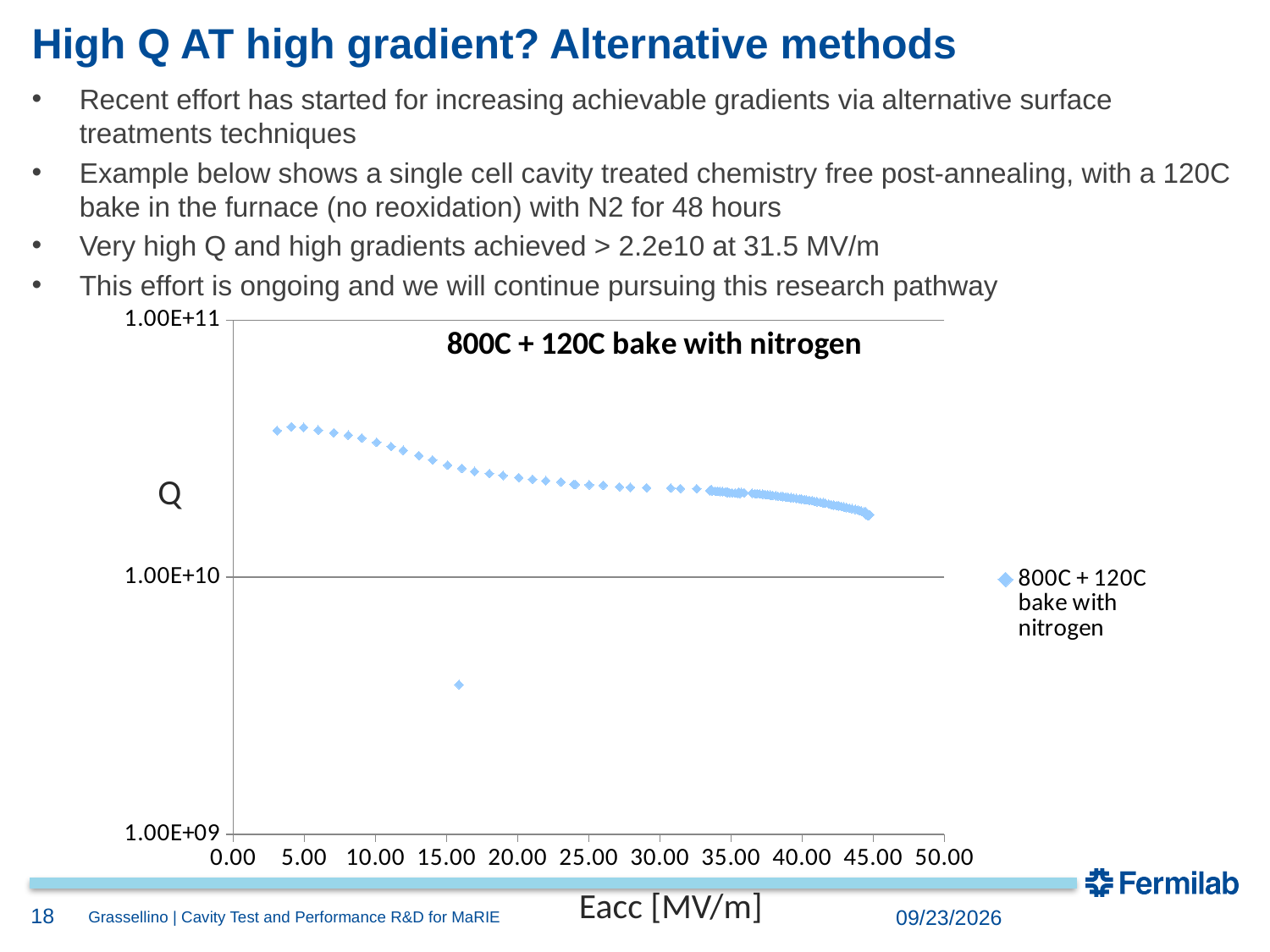
Do the Q values generally rise or fall as Eacc increases along the x axis? fall Is the isolated outlier point near Eacc of 16 MV/m greater or less than 1.00E+10? less Is the Q value at Eacc of about 45.00 MV/m greater or less than 1.00E+10? greater Is the Q value at Eacc of about 30.00 MV/m greater or less than 1.00E+11? less What is the title of the chart? 800C + 120C bake with nitrogen What is the label of the x axis of the chart? Eacc [MV/m] What kind of chart is shown on the slide? scatter chart How many series does the chart legend list? 1 What is the highest value shown on the x axis of the chart? 50.00 Which has the higher Q value: the point at Eacc of about 5.00 MV/m or the point at Eacc of about 45.00 MV/m? the point at about 5.00 MV/m